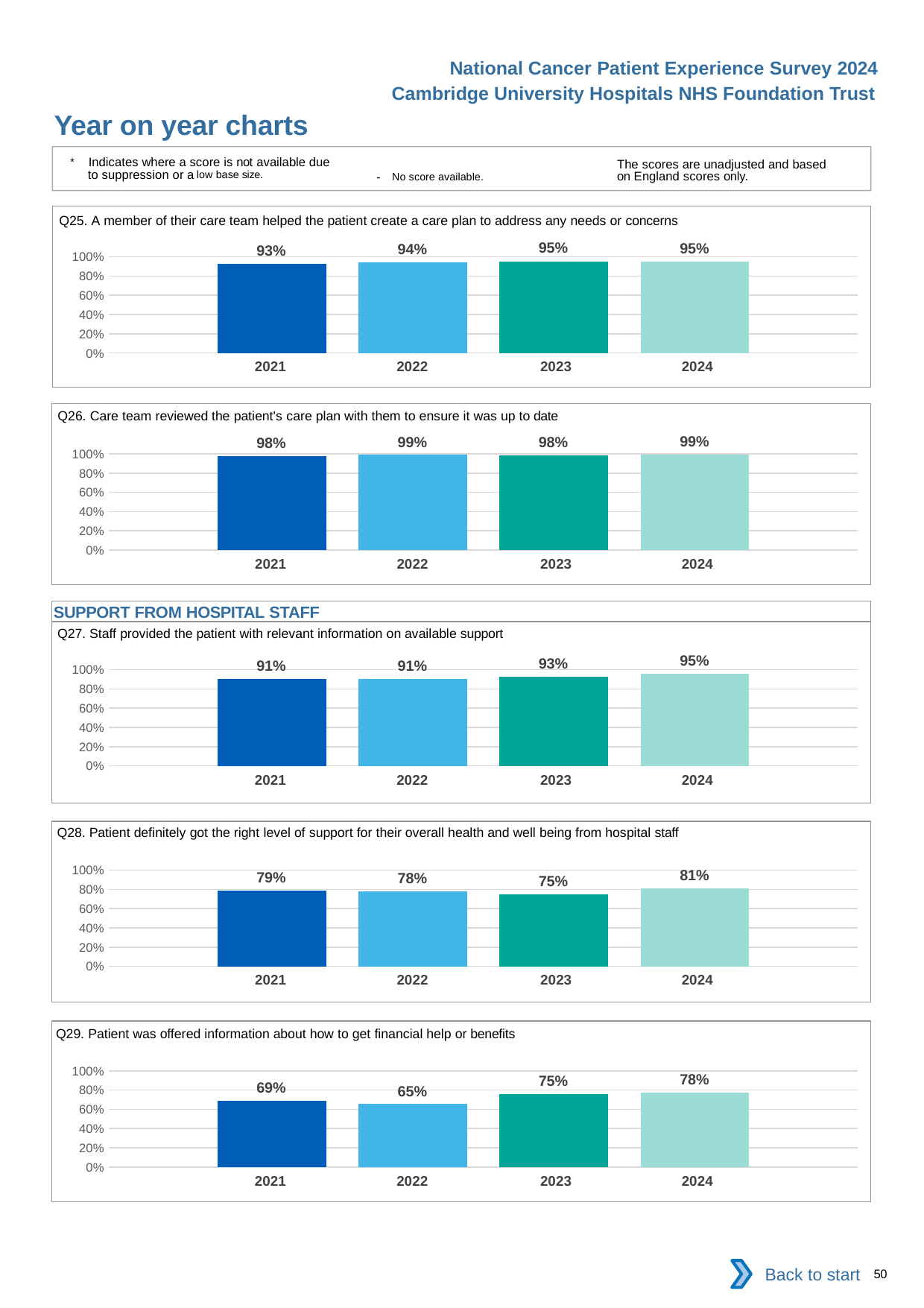
In the Q26 chart, what is the value for 2023? 98% In the Q29 chart, what is the difference between the 2024 and 2022 values? 13% In the Q28 chart, which is larger, the value for 2021 or the value for 2024? 2024 In the Q25 chart, what is the value for 2021? 93% What kind of chart is the Q25 chart? bar chart In the Q27 chart, which year has the highest value? 2024 In the Q28 chart, which year has the lowest value? 2023 In the Q29 chart, what is the value for 2023? 75% In the Q29 chart, is the value for 2022 greater or less than 80%? less How many years are shown in the Q27 chart? 4 What is the section heading shown above the Q27 chart? SUPPORT FROM HOSPITAL STAFF In the Q27 chart, do the values rise or fall from 2021 to 2024? rise